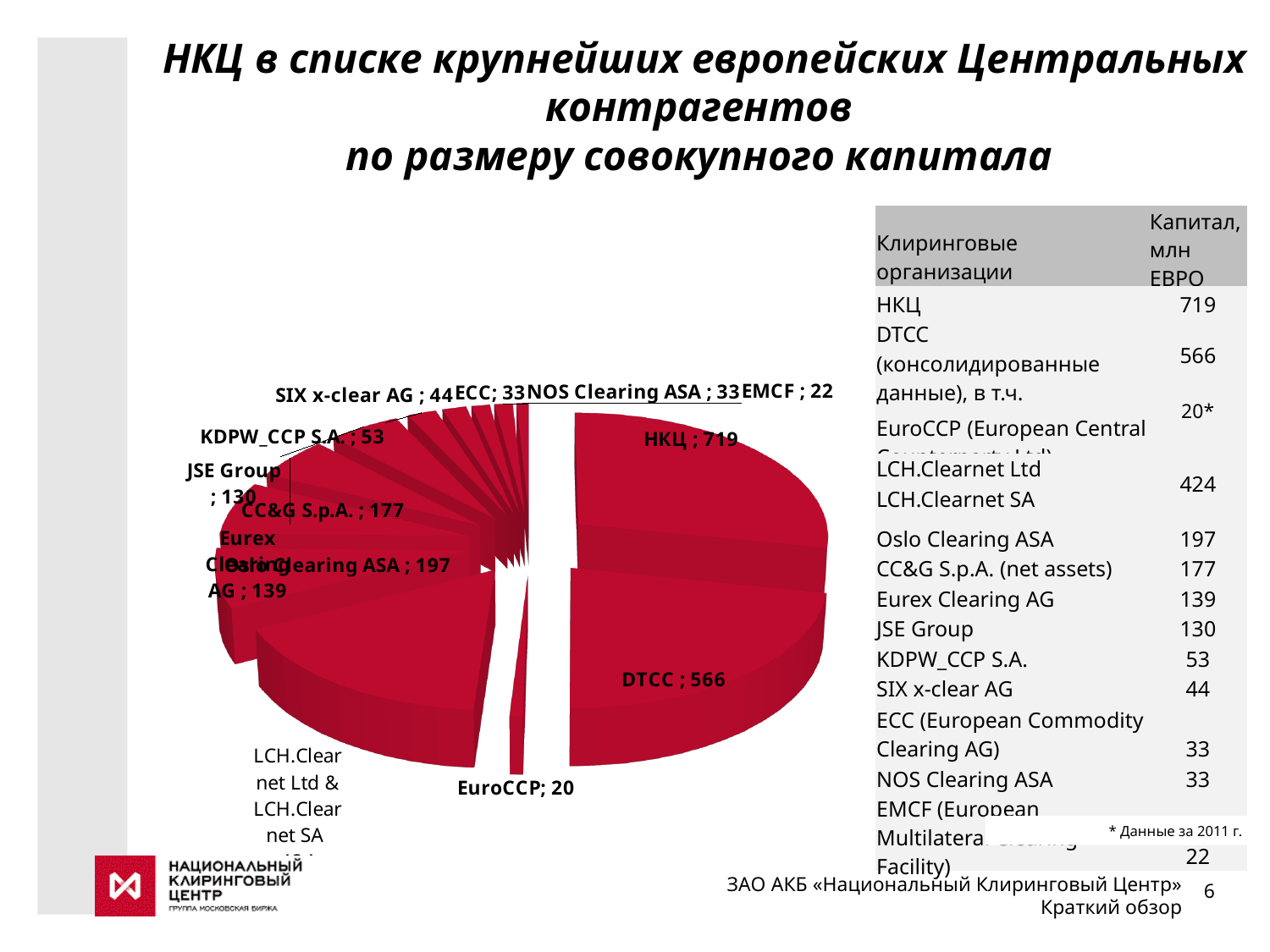
What is the value shown for EMCF in the pie chart? 22 How many slices does the pie chart have? 13 What is the value shown for Oslo Clearing ASA in the pie chart? 197 What is the value shown for НКЦ in the pie chart? 719 What is the value shown for KDPW_CCP S.A. in the pie chart? 53 What is the value shown for DTCC in the pie chart? 566 What is the difference between the values for Oslo Clearing ASA and CC&G S.p.A. in the pie chart? 20 Which is larger in the pie chart, the value for KDPW_CCP S.A. or the value for SIX x-clear AG? KDPW_CCP S.A. Which organisation has the largest slice in the pie chart? НКЦ What kind of chart is shown on the slide? pie chart What is the difference between the values for НКЦ and DTCC in the pie chart? 153 Which organisation has the smallest slice in the pie chart? EuroCCP